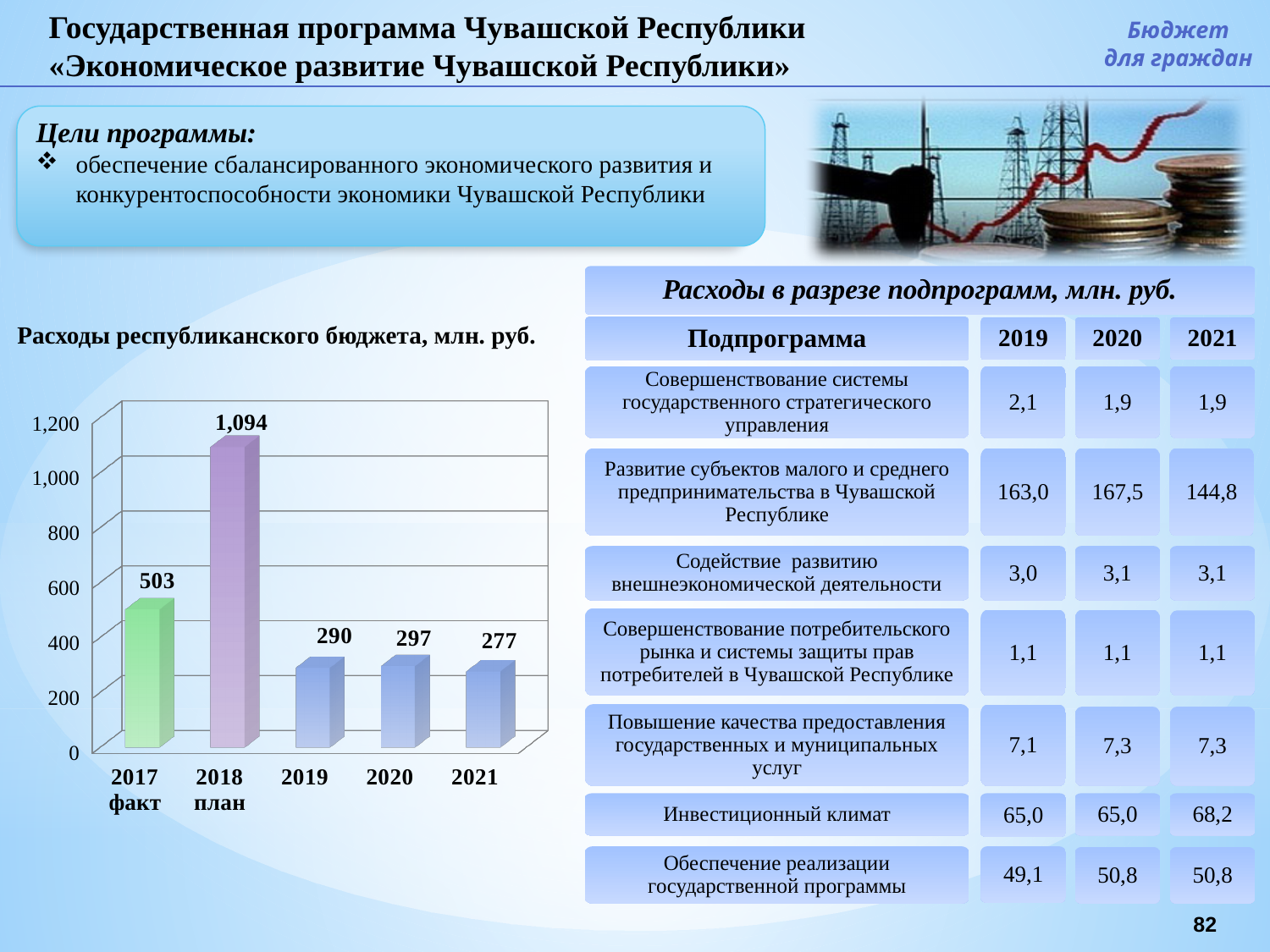
Which is larger, the value for 2019 or the value for 2020? 2020 How many categories are shown on the x axis of the chart? 5 What kind of chart is shown on the slide? bar chart What is the value for 2020 in the chart? 297 What is the difference between the values for 2018 план and 2017 факт? 591 What is the value for 2017 факт in the chart? 503 Which category has the lowest value in the chart? 2021 Which category has the highest value in the chart? 2018 план Is the value for 2017 факт greater or less than 400? greater What is the title of the chart on the slide? Расходы республиканского бюджета, млн. руб. What is the value for 2018 план in the chart? 1,094 What is the difference between the values for 2020 and 2021? 20